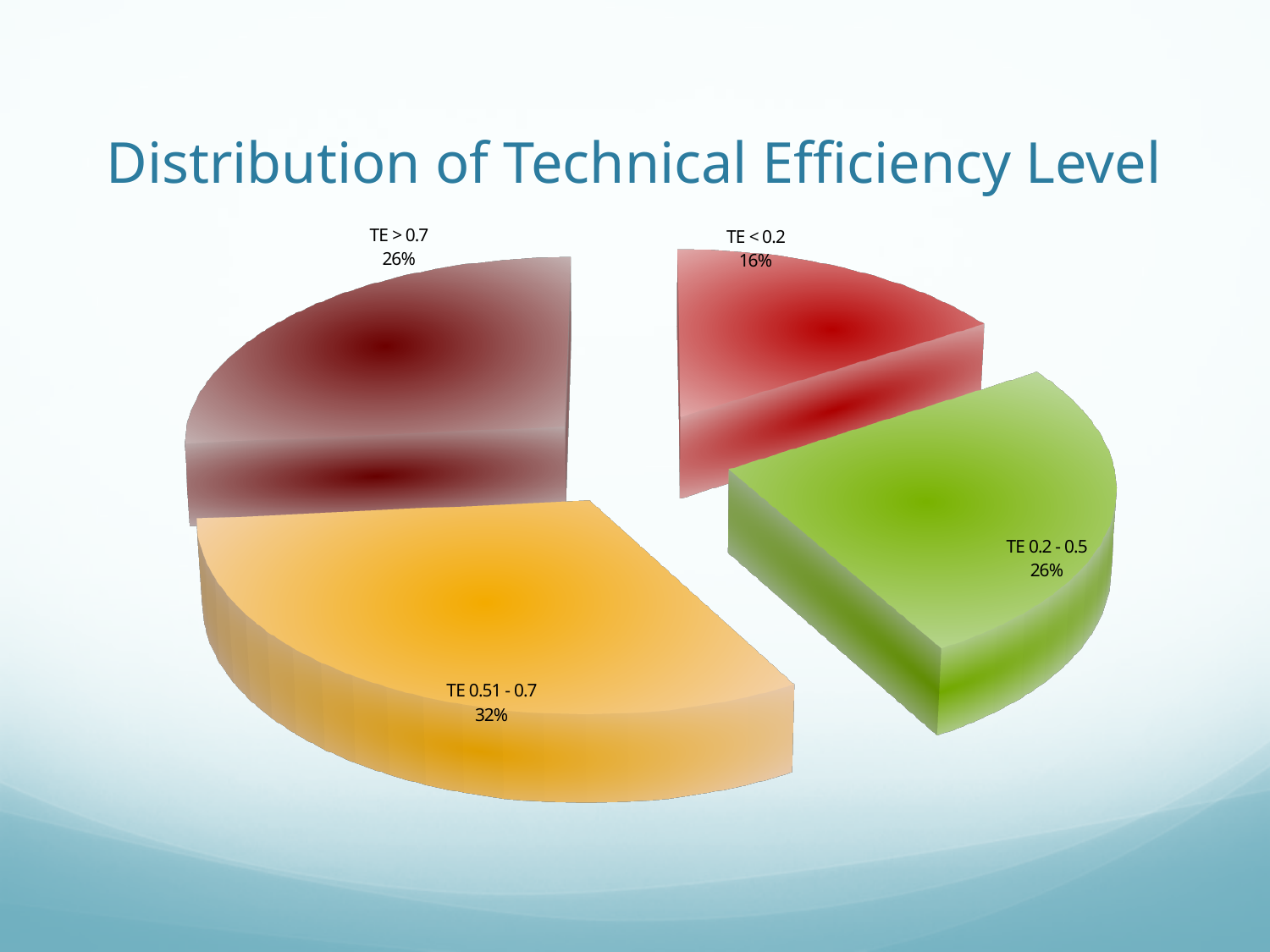
Which category has the smallest share of the pie? TE < 0.2 Which is larger, the share for TE 0.51 - 0.7 or the share for TE 0.2 - 0.5? TE 0.51 - 0.7 What share of the pie does the TE < 0.2 slice represent? 16% What kind of chart is shown on the slide? Pie chart Which category has the largest share of the pie? TE 0.51 - 0.7 What is the title of the chart? Distribution of Technical Efficiency Level What share of the pie does the TE 0.51 - 0.7 slice represent? 32% What colour is the TE 0.2 - 0.5 slice? Green What share of the pie does the TE 0.2 - 0.5 slice represent? 26% What is the difference in percentage points between the TE 0.51 - 0.7 slice and the TE < 0.2 slice? 16 How many slices does the pie chart have? 4